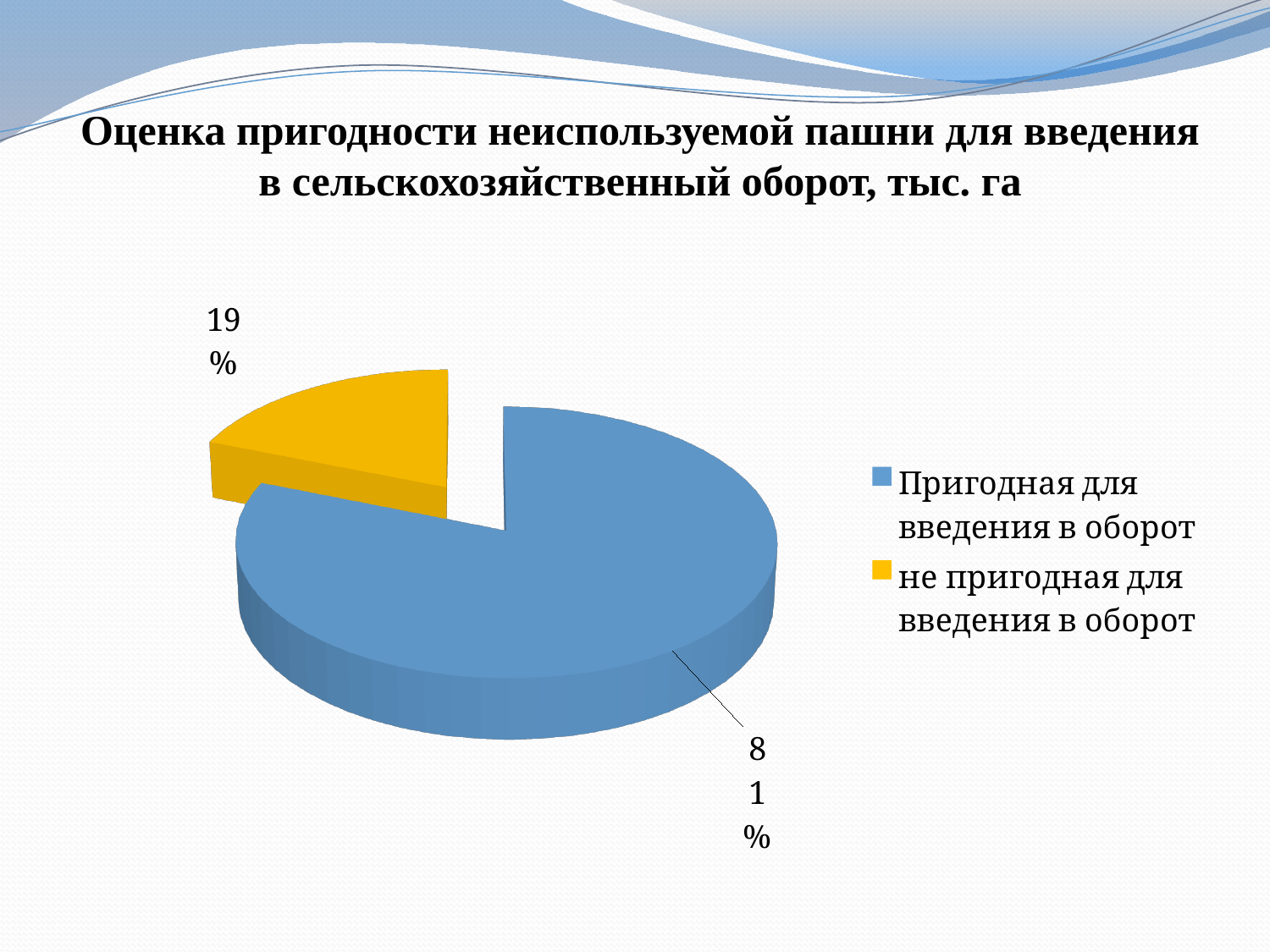
Which is larger: the share for "Пригодная для введения в оборот" or the share for "не пригодная для введения в оборот"? Пригодная для введения в оборот What colour is the slice for "не пригодная для введения в оборот"? Yellow Which slice of the pie is the smallest? не пригодная для введения в оборот What share of the pie does the slice "Пригодная для введения в оборот" represent? 81% What share of the pie does the slice "не пригодная для введения в оборот" represent? 19% What is the difference in percentage points between the "Пригодная для введения в оборот" slice and the "не пригодная для введения в оборот" slice? 62 percentage points What kind of chart is shown on the slide? Pie chart How many slices does the pie chart have? 2 What is the title of the chart on the slide? Оценка пригодности неиспользуемой пашни для введения в сельскохозяйственный оборот, тыс. га Which slice of the pie is the largest? Пригодная для введения в оборот How many entries does the legend list? 2